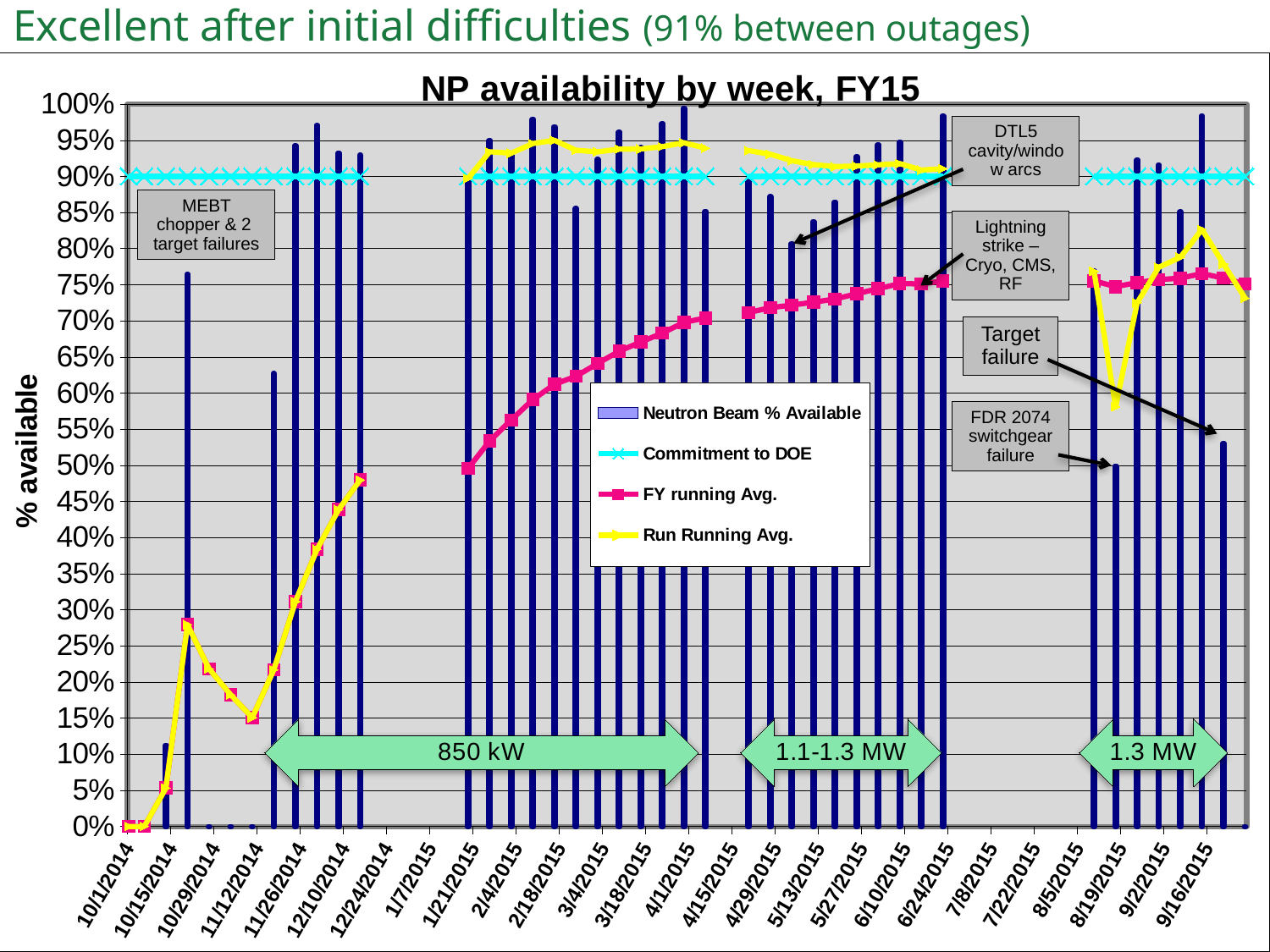
What is the title of the chart? NP availability by week, FY15 Is the Neutron Beam % Available value for 4/29/2015 greater or less than 90%? less Does the FY running Avg. line rise or fall between 1/21/2015 and 6/24/2015? rise What kind of chart is used to plot the Neutron Beam % Available series? bar chart Is the Neutron Beam % Available value for 8/19/2015 greater or less than 60%? less Is the Neutron Beam % Available value for 10/15/2014 greater or less than 20%? less At what value does the Commitment to DOE line sit? 90% What power level does the arrow spanning the period from late November 2014 to early April 2015 indicate? 850 kW How many series does the chart legend list? 4 Which has the higher Neutron Beam % Available value, 8/19/2015 or 9/2/2015? 9/2/2015 Which has the higher Neutron Beam % Available value, 10/15/2014 or 11/26/2014? 11/26/2014